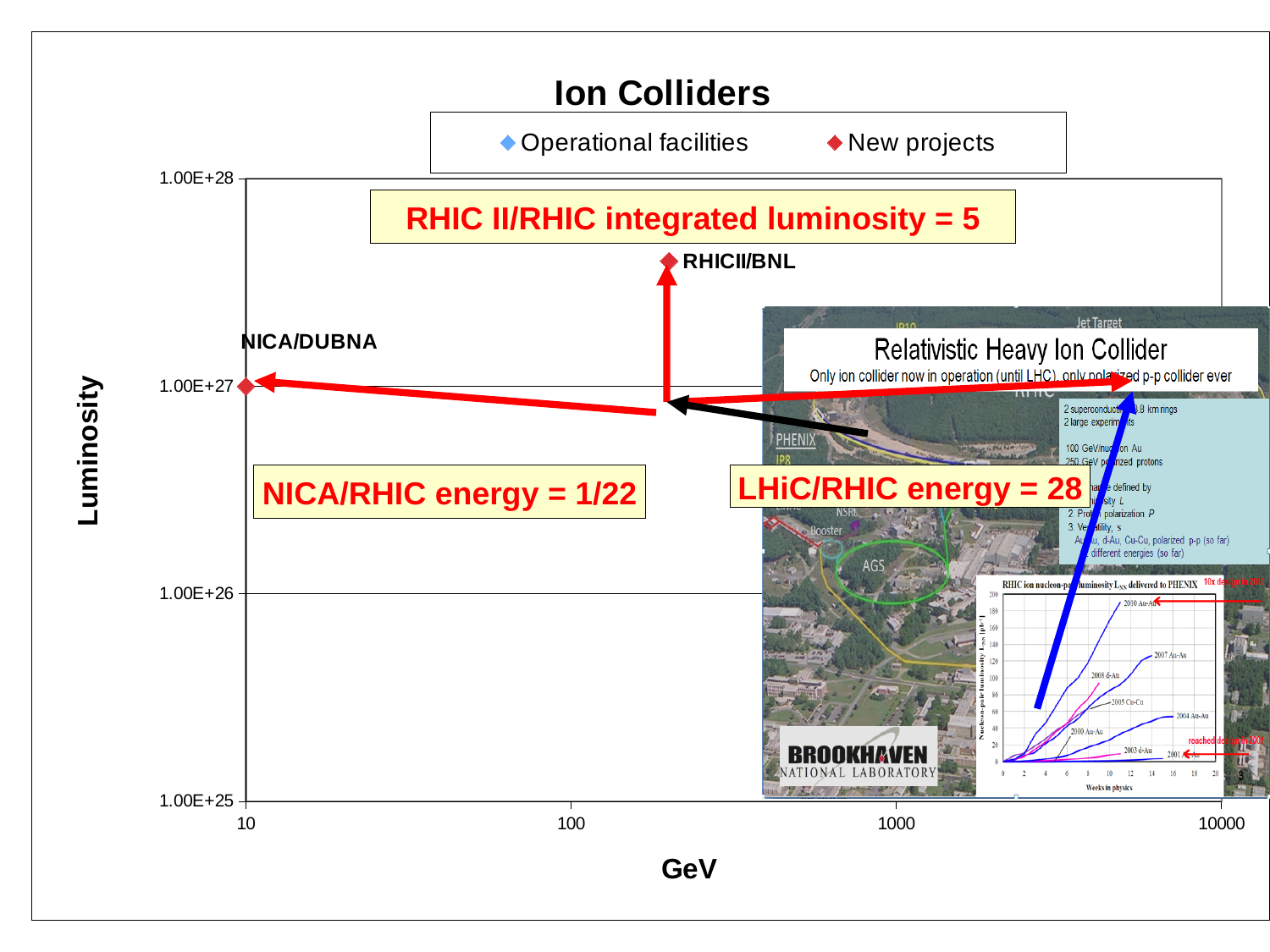
Is the GeV value for RHICII/BNL greater or less than 100? greater Is the luminosity for RHICII/BNL greater or less than 1.00E+27? greater What is the title of the chart? Ion Colliders Which has the higher luminosity, RHICII/BNL or NICA/DUBNA? RHICII/BNL How many series does the chart legend list? 2 At what GeV value is NICA/DUBNA plotted? 10 What luminosity value is plotted for NICA/DUBNA? 1.00E+27 Is the GeV value for RHICII/BNL greater or less than 1000? less What is the label of the vertical axis? Luminosity Which is plotted at a higher GeV value, NICA/DUBNA or RHICII/BNL? RHICII/BNL What kind of chart is shown on the slide? scatter chart